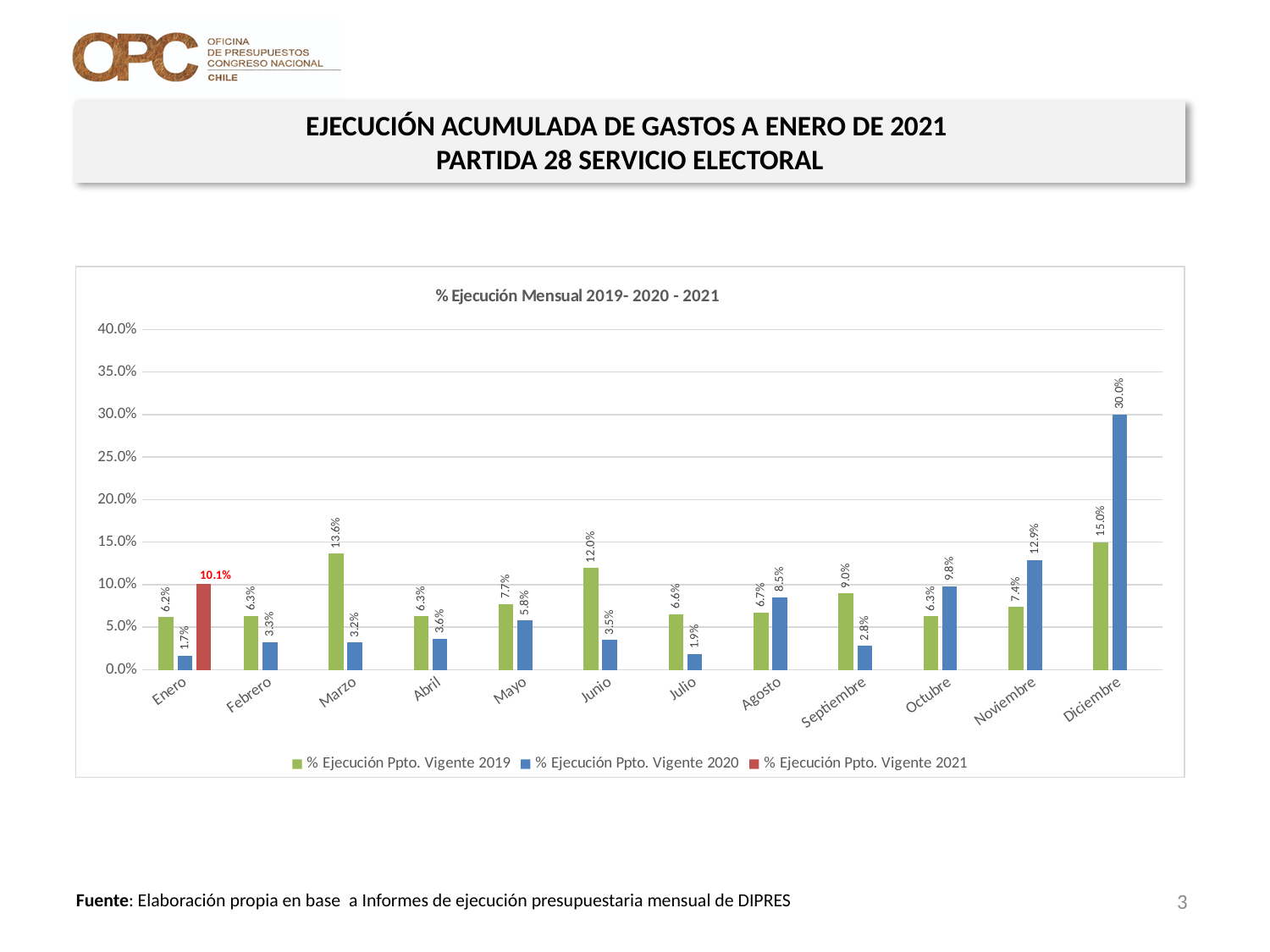
How many months are shown on the x axis? 12 Is the value for % Ejecución Ppto. Vigente 2020 in Diciembre greater or less than 25.0%? greater What is the value for % Ejecución Ppto. Vigente 2020 in Noviembre? 12.9% What is the difference between the 2020 and 2019 values in Diciembre? 15.0% What type of chart is shown on the slide? bar chart What is the value for % Ejecución Ppto. Vigente 2019 in Marzo? 13.6% In Agosto, which series has the larger value, 2019 or 2020? % Ejecución Ppto. Vigente 2020 What is the title of the chart? % Ejecución Mensual 2019- 2020 - 2021 How many series does the legend list? 3 What is the value for % Ejecución Ppto. Vigente 2021 in Enero? 10.1% In which month is the % Ejecución Ppto. Vigente 2020 value lowest? Enero In which month is the % Ejecución Ppto. Vigente 2020 value highest? Diciembre